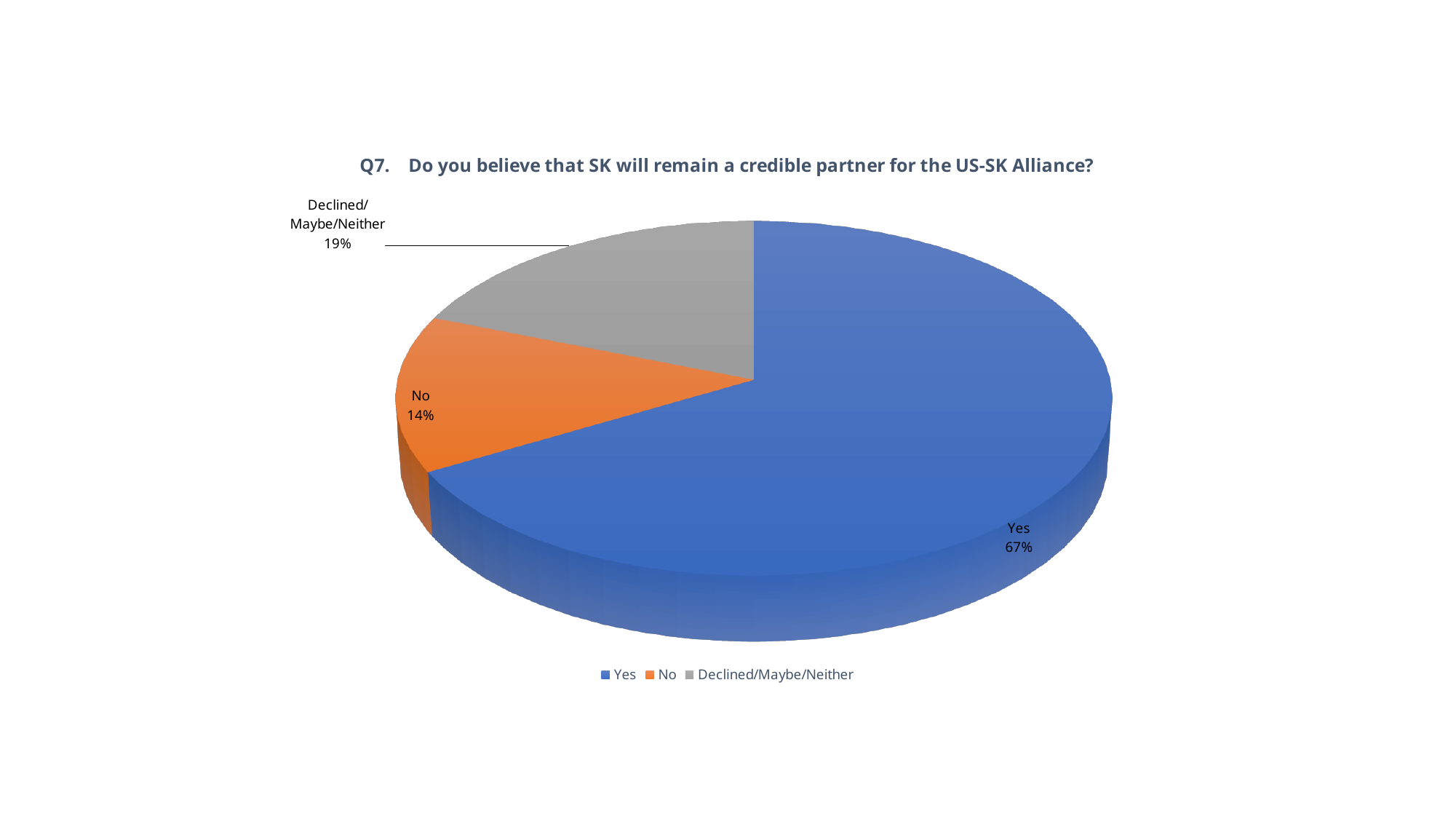
How many slices does the pie chart have? 3 What percentage of respondents answered No? 14% What percentage of respondents fall under Declined/Maybe/Neither? 19% Which is larger, the share for No or the share for Declined/Maybe/Neither? Declined/Maybe/Neither What colour is the slice for No? Orange Which response has the largest share of the pie? Yes What is the difference in percentage points between Declined/Maybe/Neither and No? 5 What percentage of respondents answered Yes? 67% Which response has the smallest share of the pie? No What is the difference in percentage points between Yes and No? 53 What kind of chart is shown on the slide? Pie chart What is the title of the chart? Q7. Do you believe that SK will remain a credible partner for the US-SK Alliance?